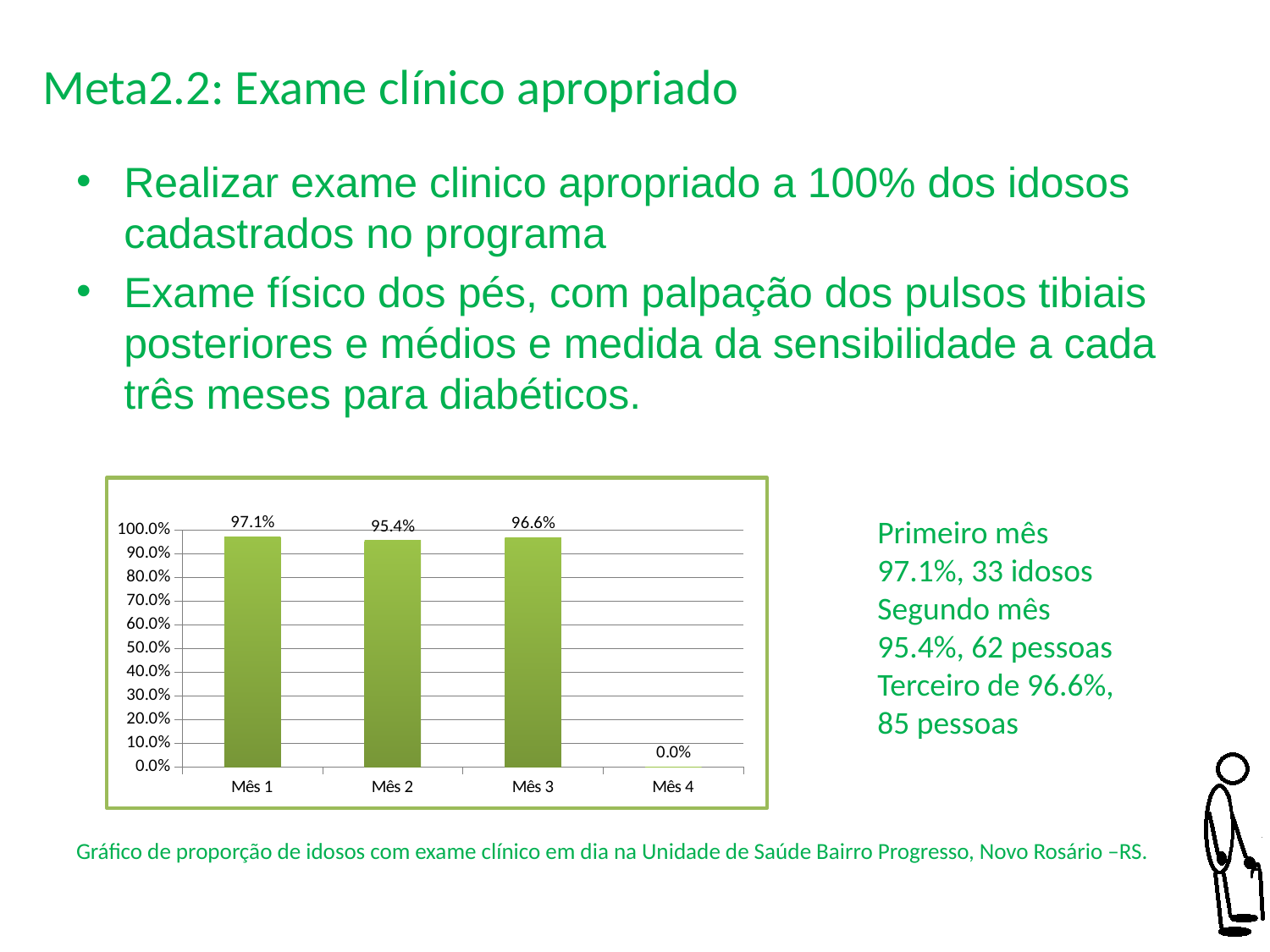
What is the highest tick value shown on the y axis? 100.0% What is the value for Mês 2? 95.4% Which is larger, the value for Mês 2 or Mês 3? Mês 3 Which month has the highest value? Mês 1 What kind of chart is shown on the slide? Bar chart What is the difference between the values for Mês 1 and Mês 2? 1.7% How many months are shown on the x axis? 4 Is the value for Mês 2 greater or less than 90.0%? greater What is the value for Mês 4? 0.0% What is the value for Mês 3? 96.6% What is the value for Mês 1? 97.1% Which month has the lowest value? Mês 4